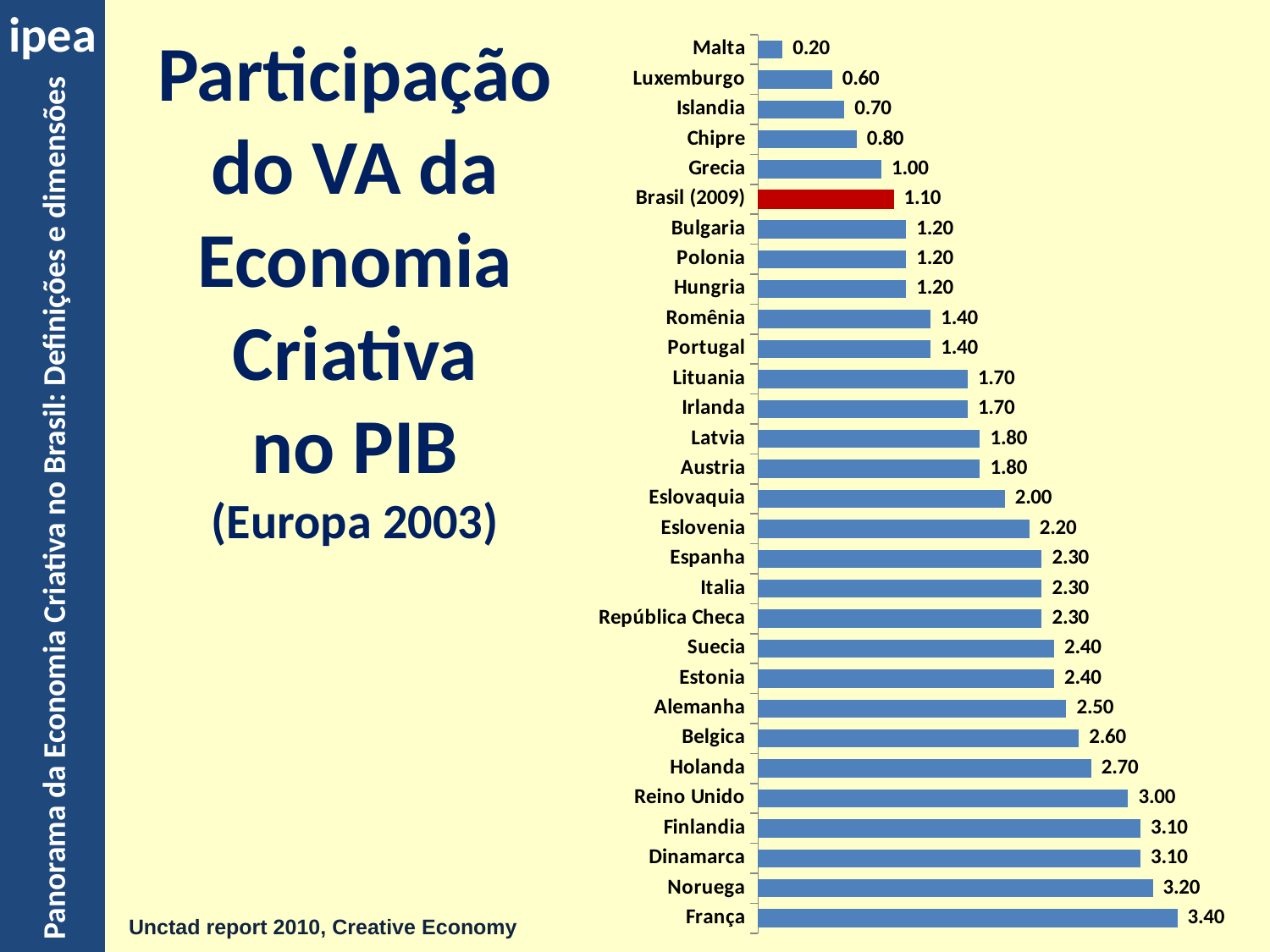
What is the difference between the values for Holanda and Grecia? 1.70 How many countries are shown in the chart? 30 What is the difference between the values for França and Brasil (2009)? 2.30 Which bar is highlighted in red? Brasil (2009) Which country has the lowest value? Malta What is the value for Portugal? 1.40 What is the value for Brasil (2009)? 1.10 What is the value for Reino Unido? 3.00 Which country has the highest value? França What kind of chart is shown on the slide? Bar chart Which has a larger value, Alemanha or Eslovenia? Alemanha Which has a larger value, Chipre or Lituania? Lituania